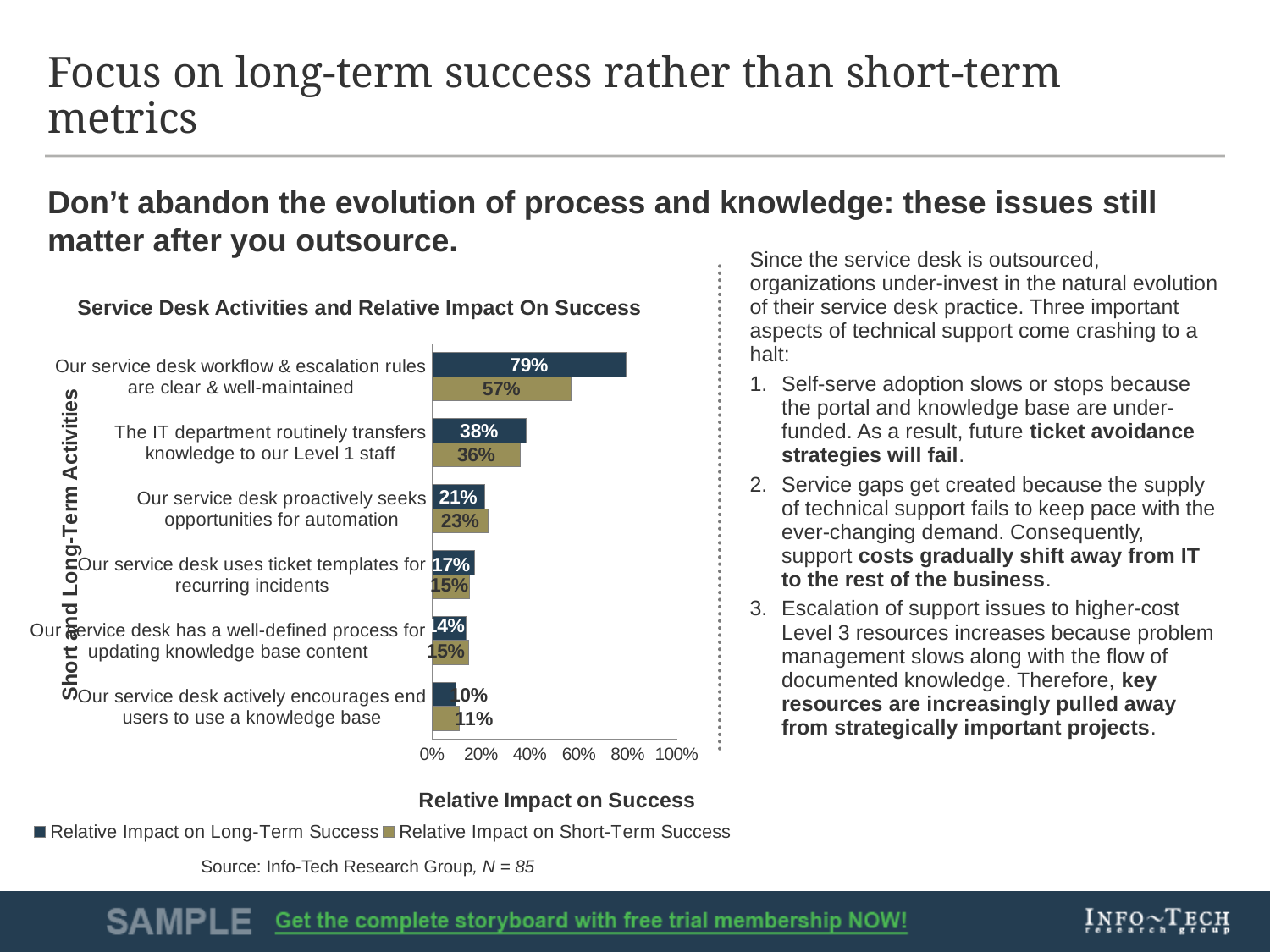
What is the Relative Impact on Long-Term Success for 'The IT department routinely transfers knowledge to our Level 1 staff'? 38% What is the difference between the Long-Term and Short-Term Success values for 'Our service desk workflow & escalation rules are clear & well-maintained'? 22% What is the Relative Impact on Long-Term Success for 'Our service desk workflow & escalation rules are clear & well-maintained'? 79% How many service desk activities (categories) are plotted in the chart? 6 Which activity has the highest Relative Impact on Long-Term Success? Our service desk workflow & escalation rules are clear & well-maintained What is the title of the chart? Service Desk Activities and Relative Impact On Success What is the Relative Impact on Short-Term Success for 'Our service desk proactively seeks opportunities for automation'? 23% What type of chart is shown on the slide? Bar chart Is the Relative Impact on Long-Term Success for 'The IT department routinely transfers knowledge to our Level 1 staff' greater or less than 40%? less How many series does the chart legend list? 2 What is the Relative Impact on Short-Term Success for 'Our service desk workflow & escalation rules are clear & well-maintained'? 57% For 'Our service desk uses ticket templates for recurring incidents', which is larger: the Long-Term Success value or the Short-Term Success value? Long-Term Success (17%)